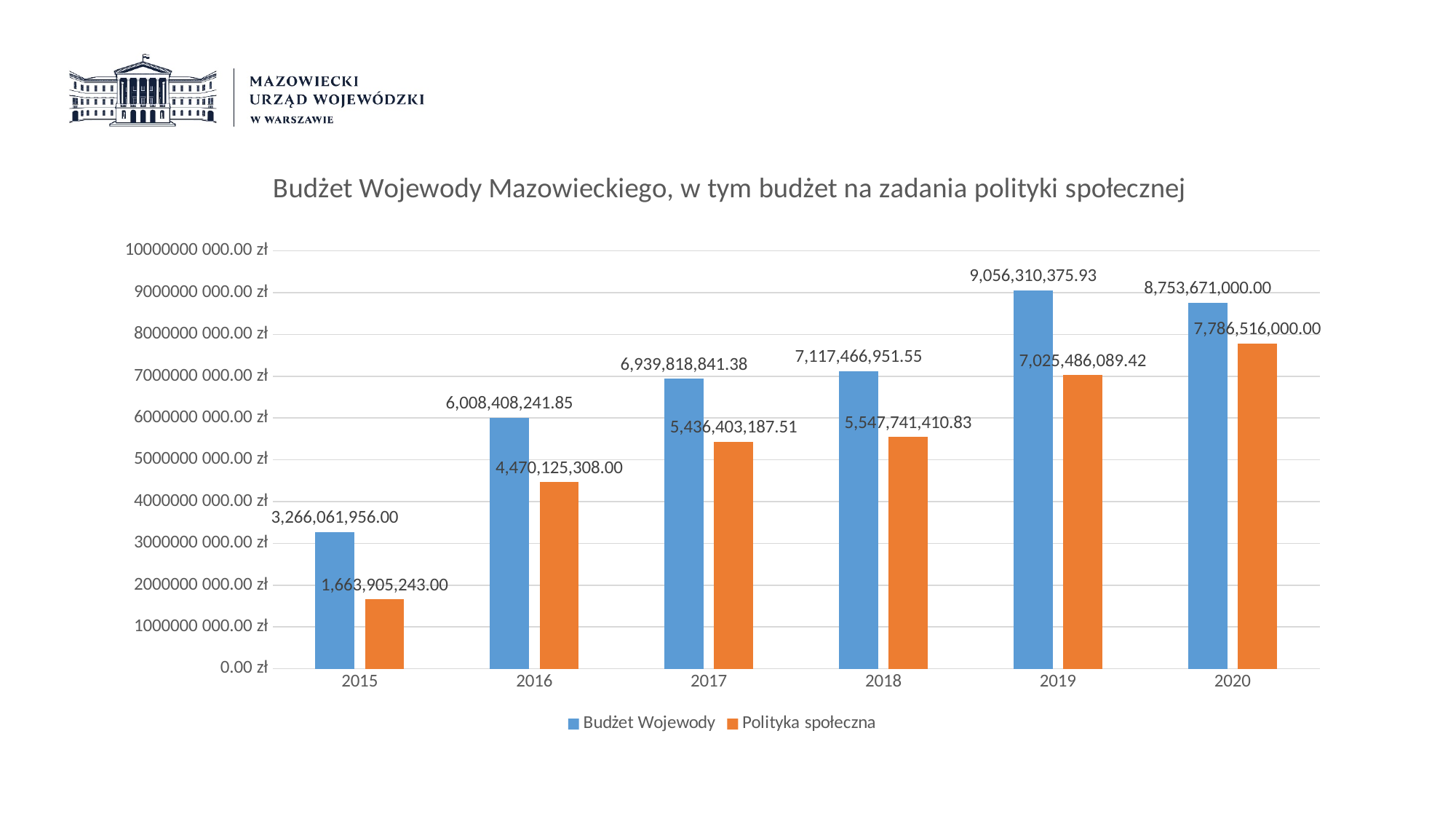
What is the value of Budżet Wojewody for 2019? 9,056,310,375.93 How many series does the legend list? 2 Is the value of Budżet Wojewody for 2018 greater or less than 7000000 000.00 zł? greater What is the value of Polityka społeczna for 2016? 4,470,125,308.00 What is the difference between Budżet Wojewody and Polityka społeczna in 2020? 967,155,000.00 What kind of chart is shown on the slide? bar chart Which is larger: Polityka społeczna in 2019 or Polityka społeczna in 2020? Polityka społeczna in 2020 What is the value of Polityka społeczna for 2020? 7,786,516,000.00 In which year is Polityka społeczna lowest? 2015 What is the value of Budżet Wojewody for 2017? 6,939,818,841.38 In which year is Budżet Wojewody highest? 2019 How many years are shown on the x axis? 6